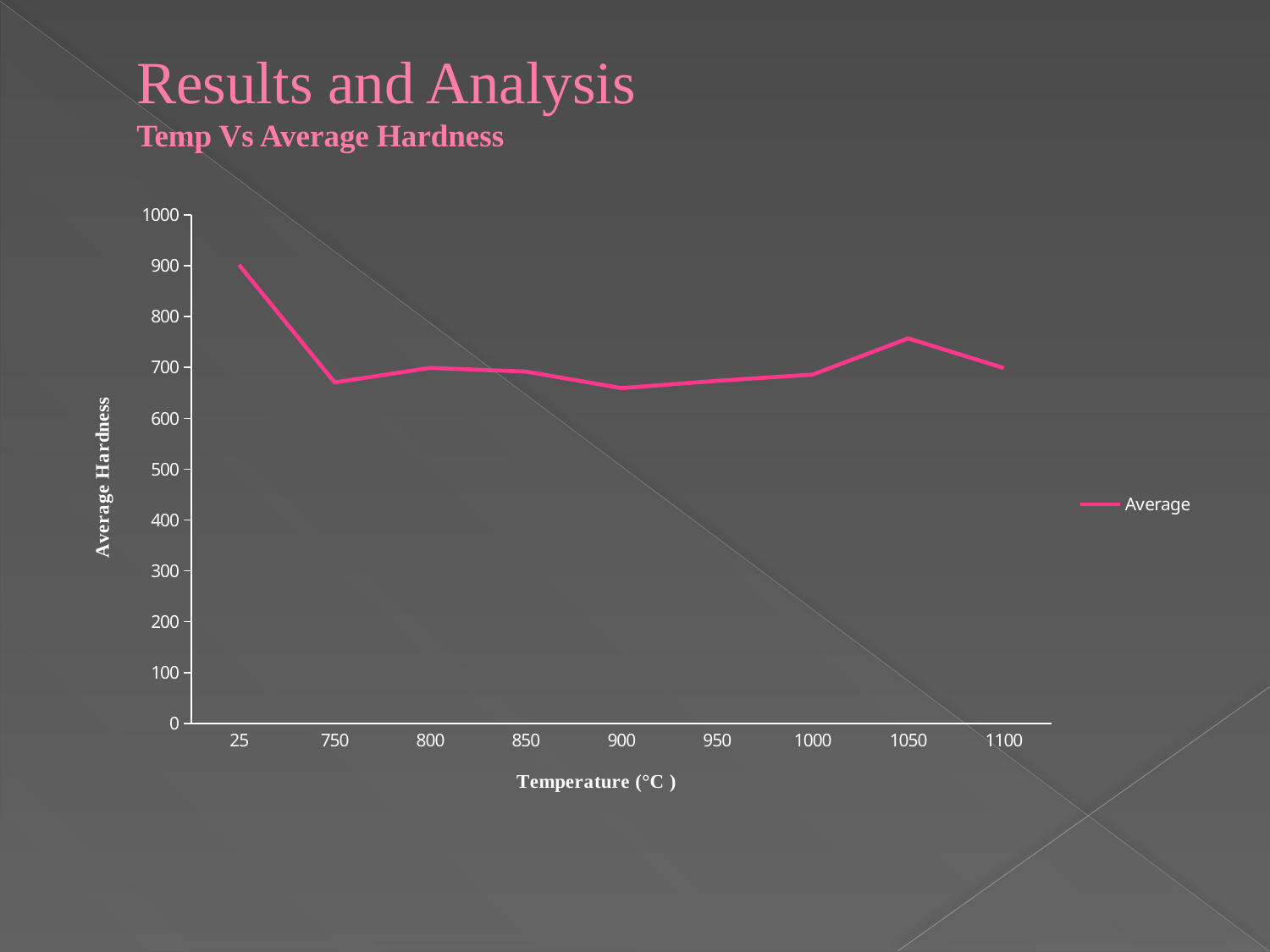
Which has the higher average hardness, 25 or 1050? 25 Is the average hardness at 900 greater or less than 700? less What is the title of the x axis? Temperature (°C ) At which temperature is the average hardness highest? 25 What kind of chart is shown on the slide? line chart Is the average hardness at 750 greater or less than 700? less How many temperature points are plotted on the chart? 9 Does the average hardness rise or fall between 25 and 750? fall How many series does the legend list? 1 Is the average hardness at 1050 greater or less than 800? less